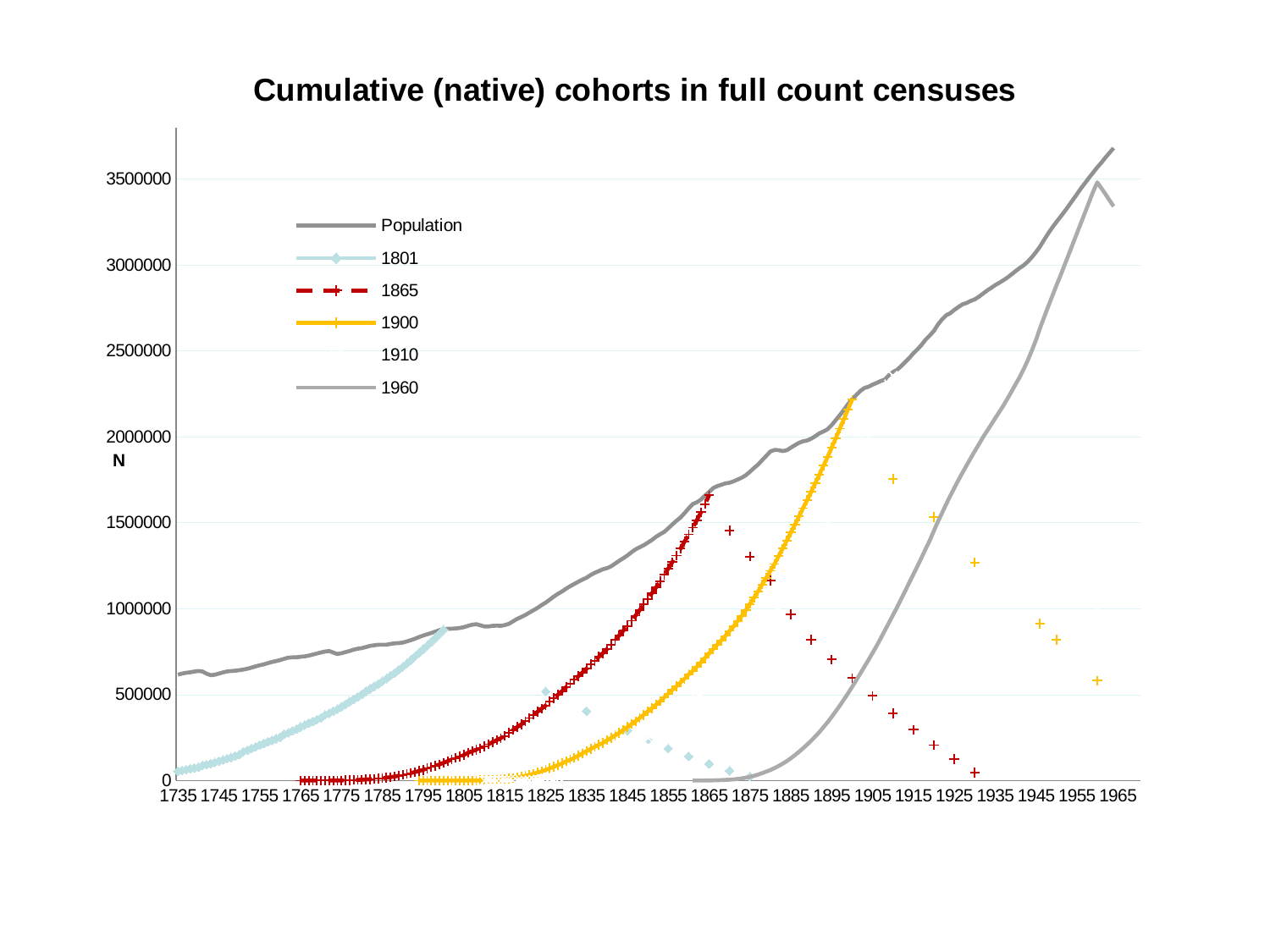
What is the title of the chart? Cumulative (native) cohorts in full count censuses What kind of chart is shown on the slide? line chart What is the label on the vertical axis? N Is the highest value of the 1801 series greater or less than 1000000? less Is the highest value of the 1960 series greater or less than 3000000? greater Is the highest value of the 1865 series greater or less than 2000000? less How many series does the legend list? 6 Does the Population series generally rise or fall from 1735 to 1965? rise How many year labels are shown along the x axis? 24